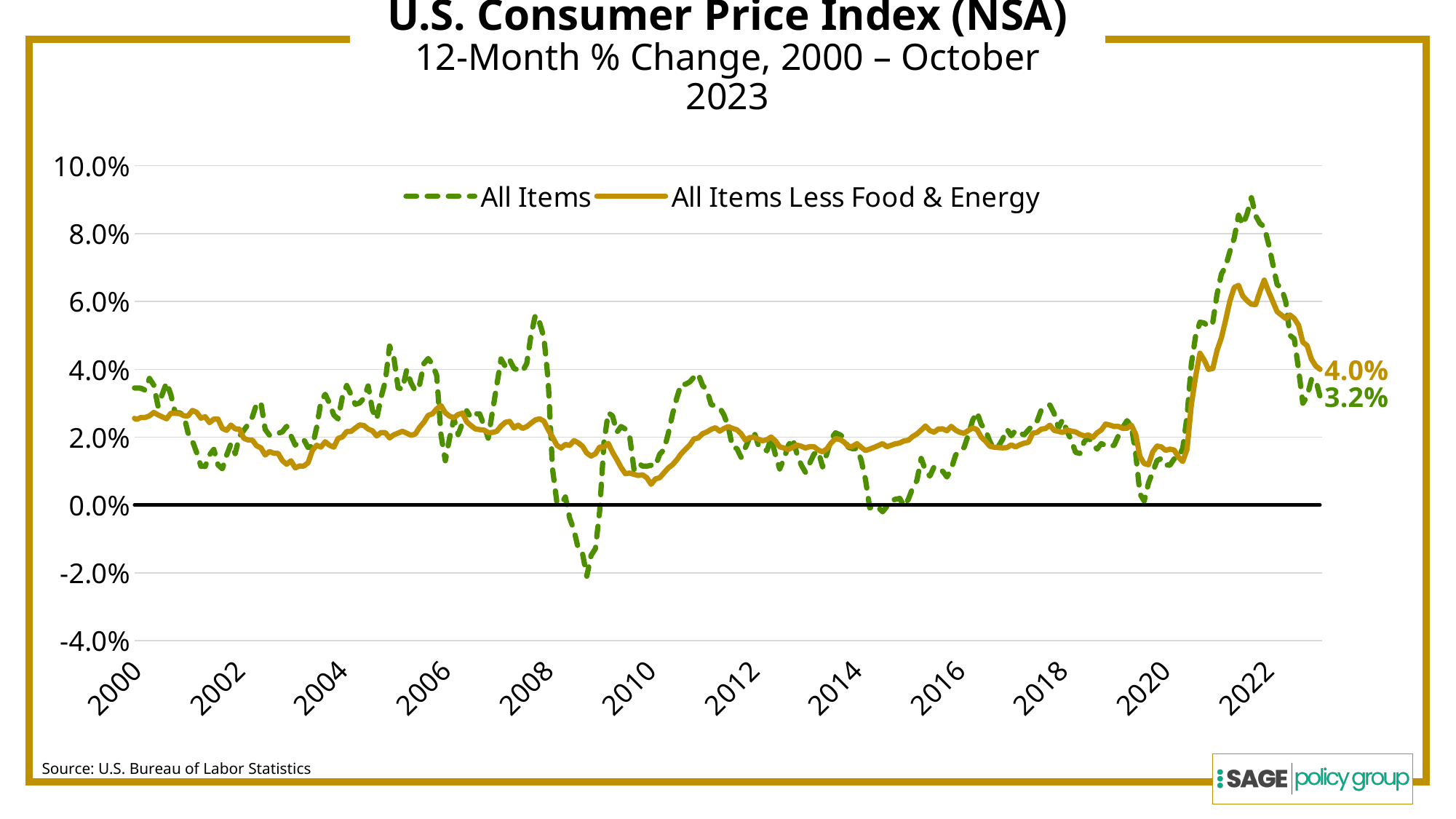
What source is cited for the chart data? U.S. Bureau of Labor Statistics How many series does the legend list? 2 At the end of the series in October 2023, which is larger: All Items or All Items Less Food & Energy? All Items Less Food & Energy Which series is drawn as a dashed green line? All Items Is the peak value of the All Items series around 2022 greater or less than 8.0%? greater Is the peak value of the All Items Less Food & Energy series around 2022 greater or less than 6.0%? greater What is the final labelled value for the All Items Less Food & Energy series in October 2023? 4.0% What is the difference between the final labelled values of All Items Less Food & Energy and All Items? 0.8% What is the final labelled value for the All Items series in October 2023? 3.2% Does the All Items series rise or fall between its 2022 peak and October 2023? Fall What kind of chart is shown on the slide? Line chart Is the lowest value of the All Items series around 2009 greater or less than 0.0%? less